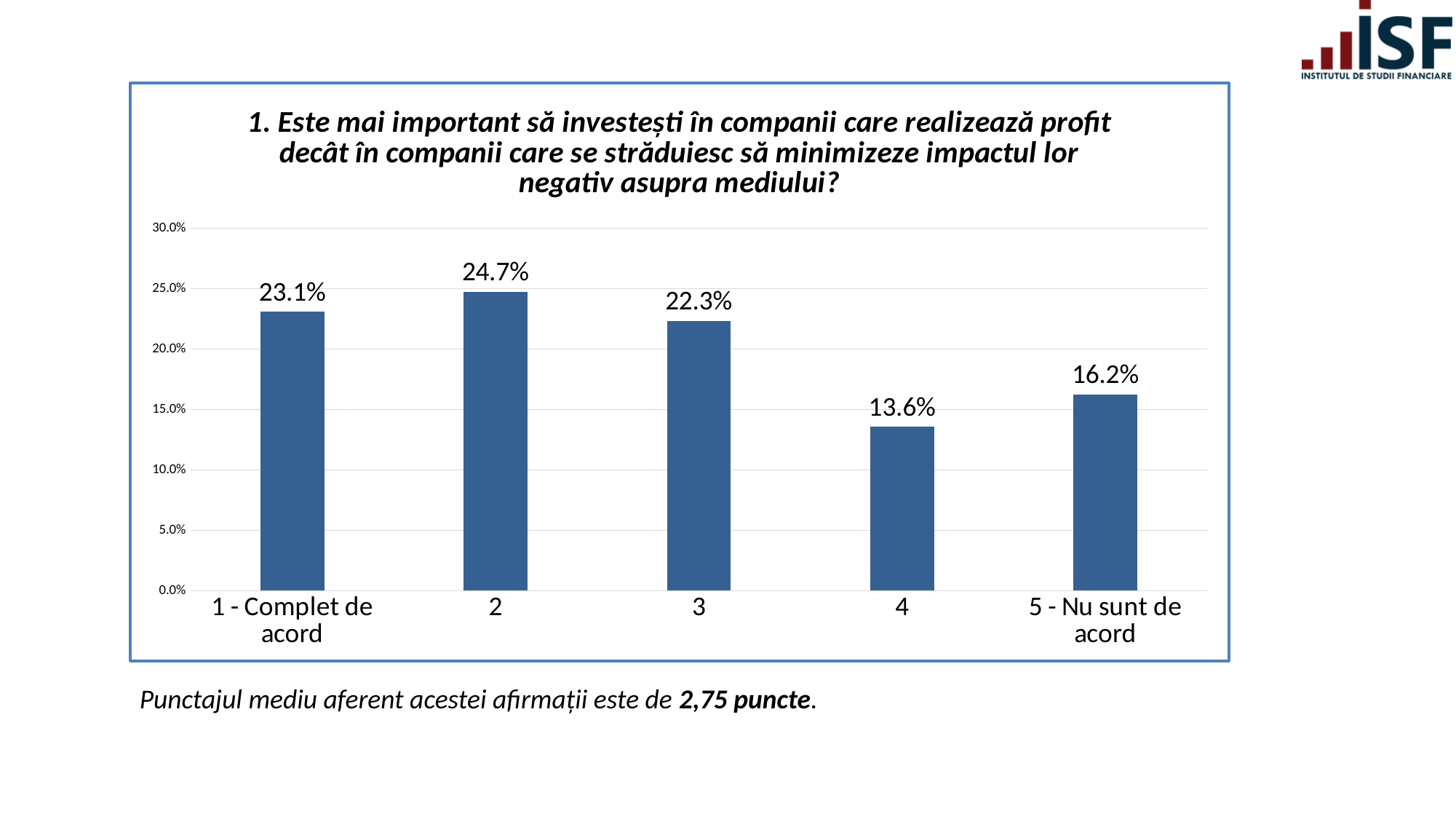
What kind of chart is shown on the slide? bar chart What is the value for category 2? 24.7% Which is larger, the value for category 3 or the value for category "5 - Nu sunt de acord"? 3 Is the value for category 4 greater or less than 15.0%? less What is the value for category 4? 13.6% How many categories are shown on the x axis? 5 What is the value for category "5 - Nu sunt de acord"? 16.2% What is the difference between the values for category 2 and category 4? 11.1% What is the average score stated in the text below the chart? 2,75 puncte What is the value for category "1 - Complet de acord"? 23.1% Which category has the lowest value? 4 Which category has the highest value? 2